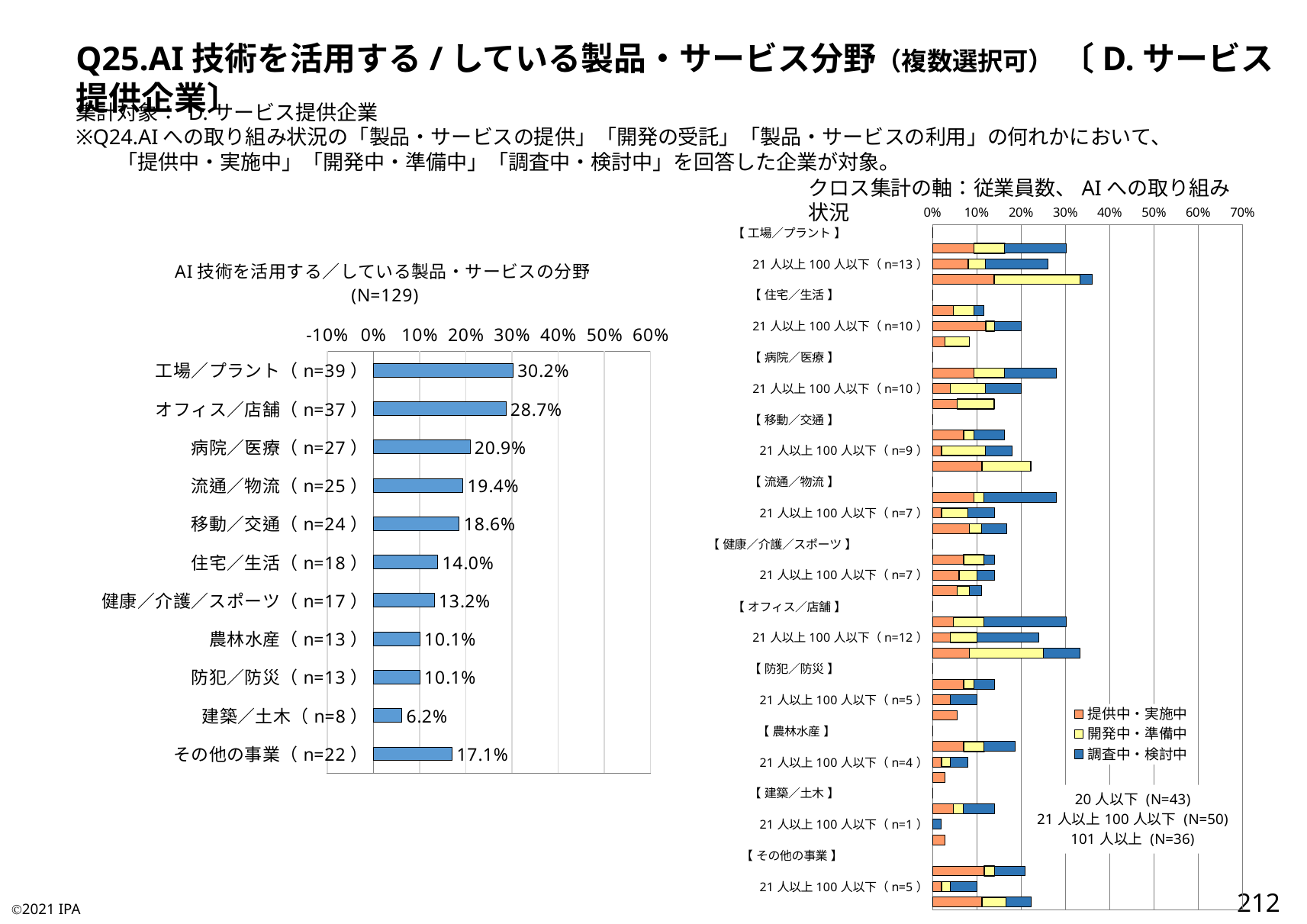
In the left chart 'AI技術を活用する／している製品・サービスの分野', what is the value for 病院／医療? 20.9% In the left chart 'AI技術を活用する／している製品・サービスの分野', which category has the highest value? 工場／プラント In the left chart 'AI技術を活用する／している製品・サービスの分野', what is the difference between 工場／プラント and オフィス／店舗? 1.5% In the left chart 'AI技術を活用する／している製品・サービスの分野', how many categories are plotted? 11 What kind of chart is the right chart on the slide? Stacked bar chart In the left chart 'AI技術を活用する／している製品・サービスの分野', what is the value for 工場／プラント? 30.2% In the left chart 'AI技術を活用する／している製品・サービスの分野', what is the N shown in the title? 129 In the right stacked chart, is the total for the 101人以上 bar under 工場／プラント greater or less than 30%? greater In the right stacked chart, how many series does the legend list? 3 In the left chart 'AI技術を活用する／している製品・サービスの分野', what is the value for その他の事業? 17.1% In the left chart 'AI技術を活用する／している製品・サービスの分野', which category has the lowest value? 建築／土木 In the left chart 'AI技術を活用する／している製品・サービスの分野', which is larger, 流通／物流 or 移動／交通? 流通／物流